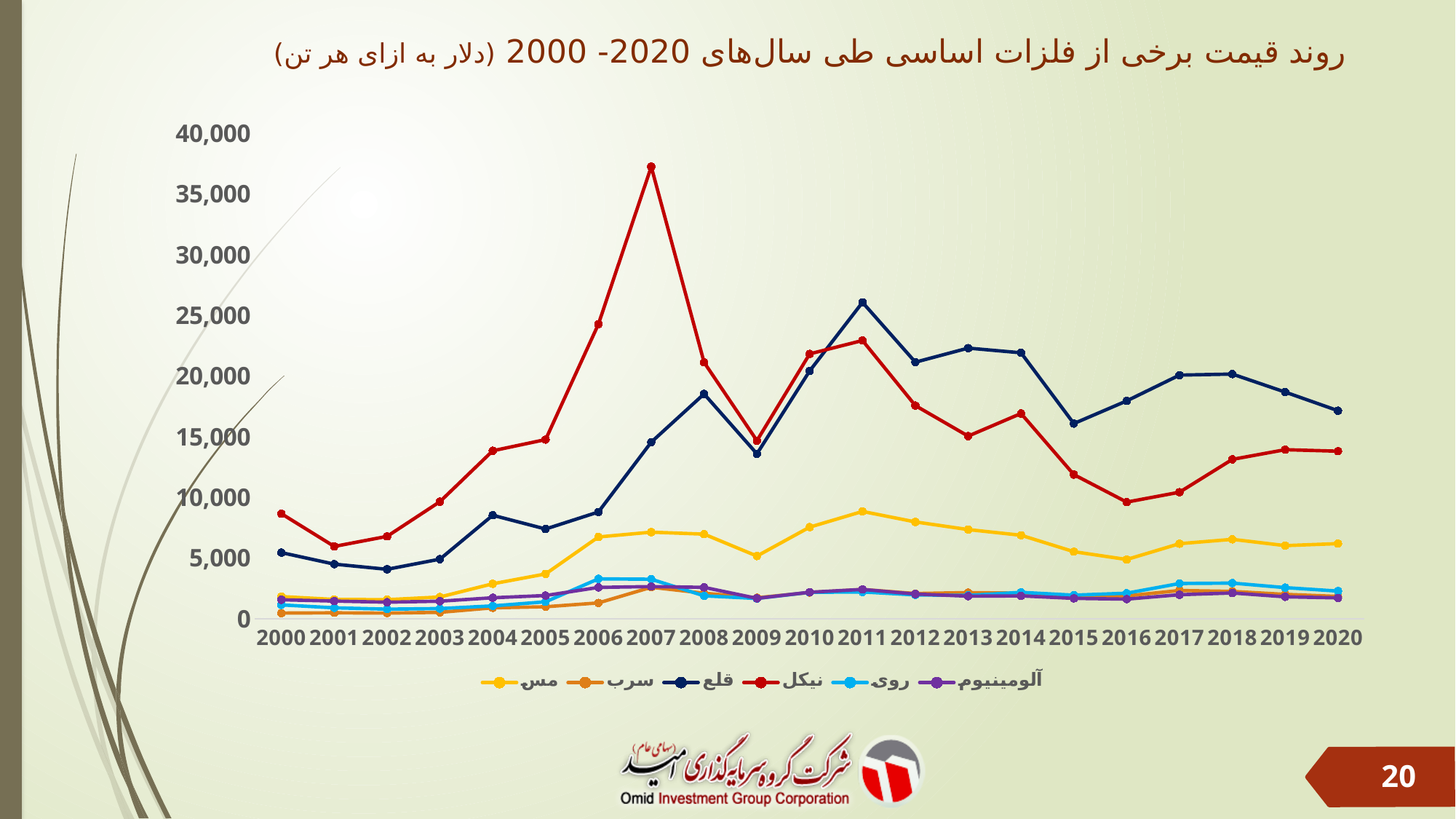
How many series does the legend list? 6 In which year does the قلع (dark blue) series reach its highest value? 2011 Is the value for قلع in 2002 greater or less than 5,000? less Is the value for قلع in 2011 greater or less than 25,000? greater In which year does the نیکل (red) series reach its highest value? 2007 Does the نیکل series rise or fall between 2007 and 2009? fall Is the value for قلع in 2020 greater or less than 15,000? greater How many years are plotted along the x axis? 21 Which series has the higher value in 2020, قلع or نیکل? قلع Which series is shown in yellow in the legend? مس What kind of chart is shown on the slide? line chart